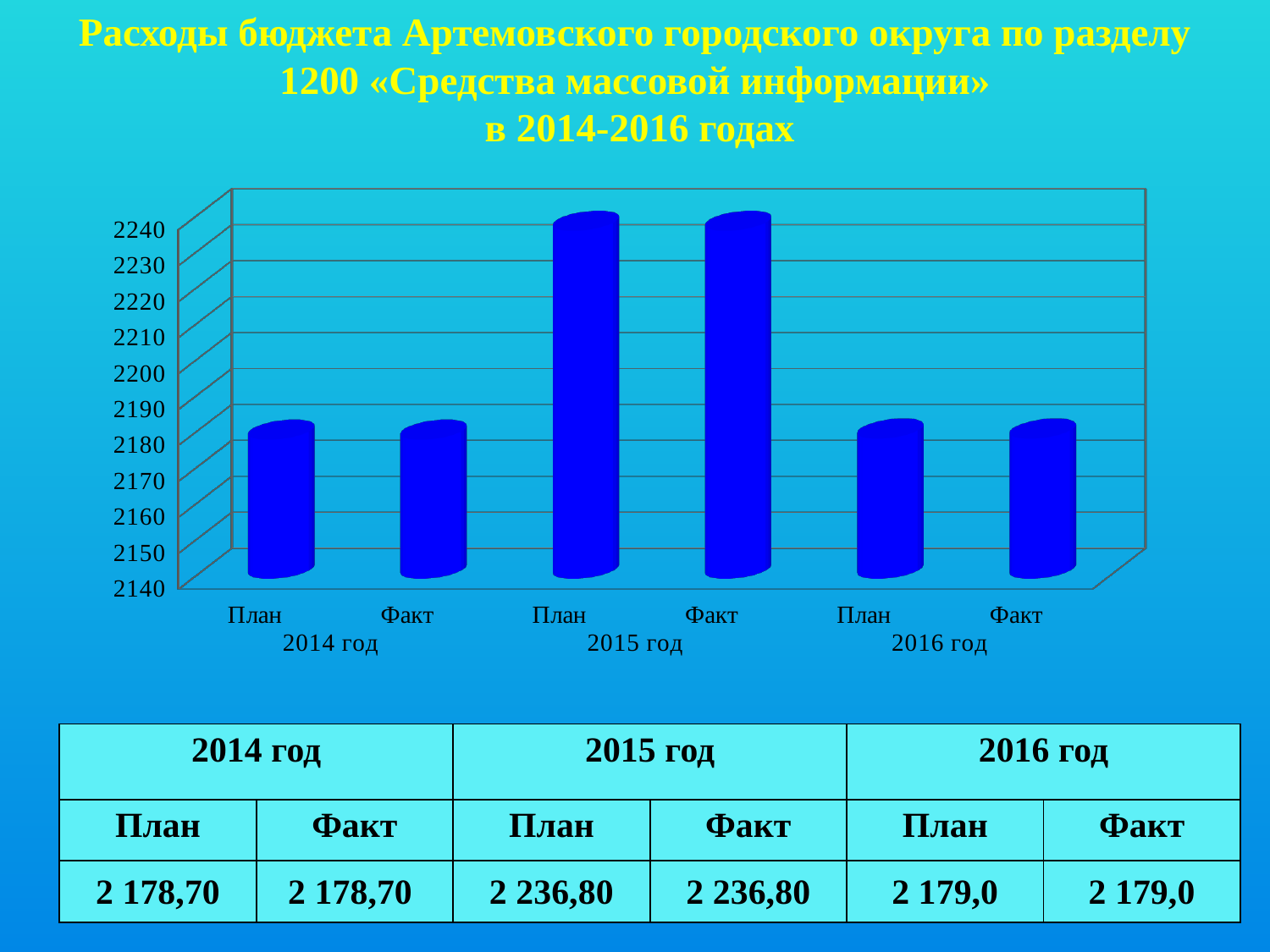
How many bars are plotted in the chart? 6 Which year has the highest bars in the chart? 2015 год According to the table, what is the План value for 2015 год? 2 236,80 Which is larger, the Факт value for 2015 год or the Факт value for 2016 год? 2015 год What is the lowest value shown on the vertical axis of the chart? 2140 What kind of chart is shown on the slide? bar chart Which budget section number is named in the slide title? 1200 According to the table, what is the План value for 2016 год? 2 179,0 Is the value of the Факт bar for 2015 год greater or less than 2220? greater According to the table, what is the Факт value for 2014 год? 2 178,70 Is the value of the План bar for 2014 год greater or less than 2200? less Using the table values, what is the difference between the План value for 2015 год and the План value for 2014 год? 58,10